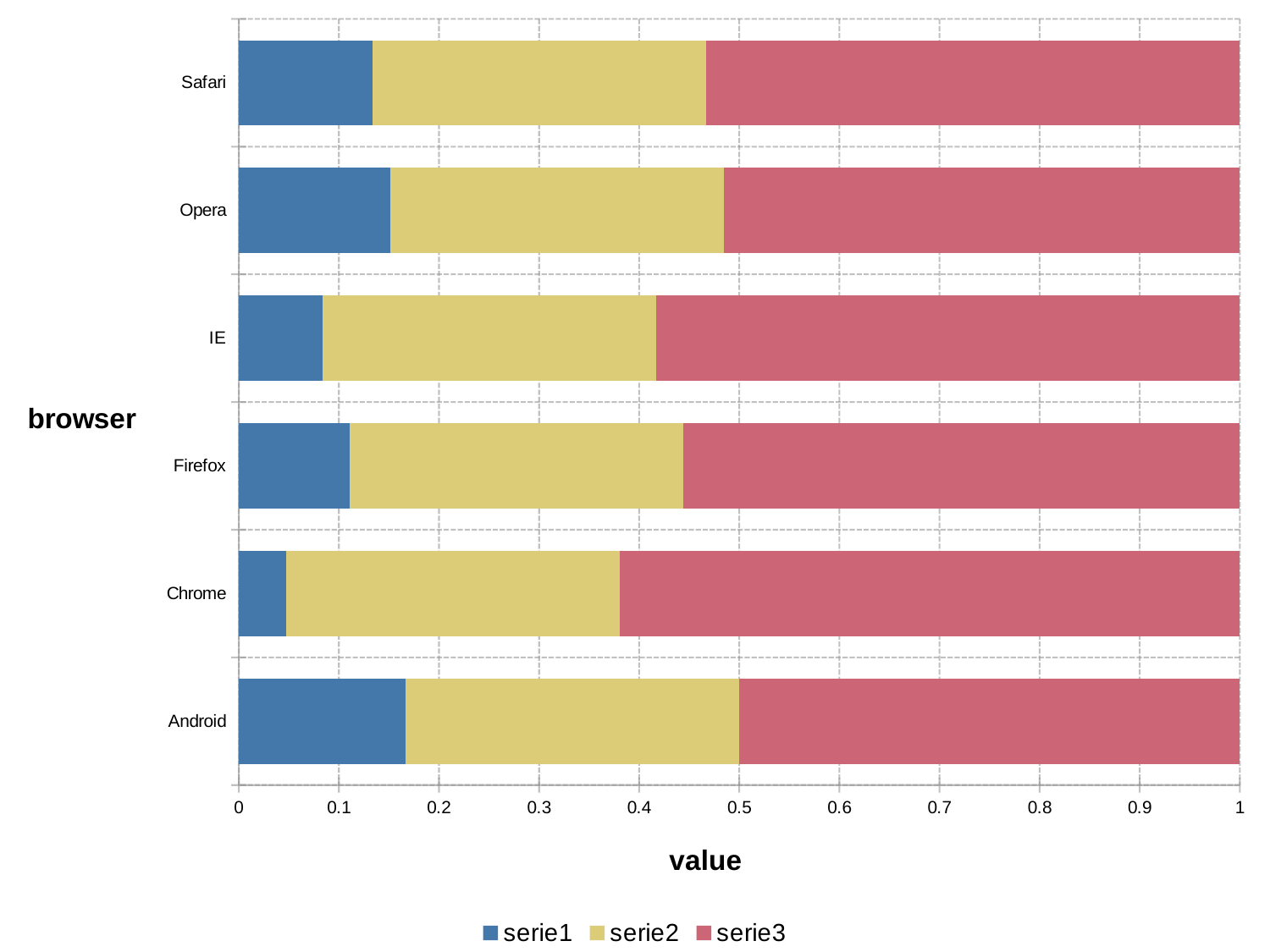
Which colour represents serie3 in the legend? red What kind of chart is shown on the slide? bar chart Which has the larger serie1 value, IE or Safari? Safari What is the total of the stacked bar for Safari? 1 What is the title of the horizontal axis? value Which browser has the lowest serie1 value? Chrome How many series does the legend list? 3 Which has the larger serie1 value, Chrome or Android? Android Is the serie1 value for Opera greater or less than 0.1? greater Is the serie1 value for Android greater or less than 0.1? greater Is the serie1 value for Chrome greater or less than 0.1? less How many browsers are listed on the vertical axis? 6